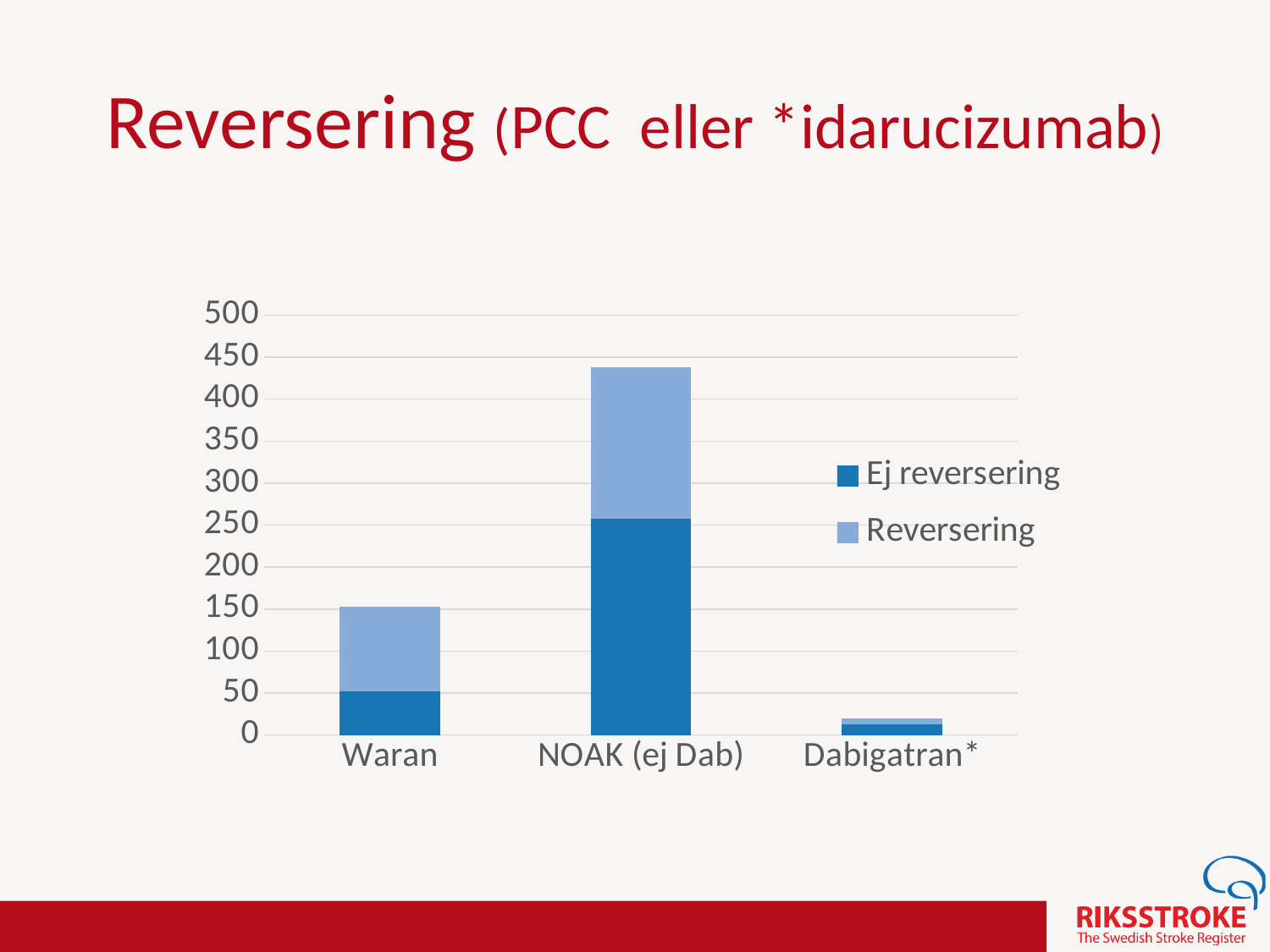
Is the total stacked value for Dabigatran* greater or less than 50? less Is the total stacked value for NOAK (ej Dab) greater or less than 400? greater Which category has the shortest stacked bar? Dabigatran* What are the two series names listed in the chart's legend? Ej reversering and Reversering Which is larger for Waran: the Ej reversering segment or the Reversering segment? Reversering Is the Ej reversering value for NOAK (ej Dab) greater or less than 200? greater Which category has the tallest stacked bar? NOAK (ej Dab) Which is larger for NOAK (ej Dab): the Ej reversering segment or the Reversering segment? Ej reversering How many categories are shown on the x axis of the chart? 3 How many series does the chart's legend list? 2 What kind of chart is shown on the slide? stacked bar chart